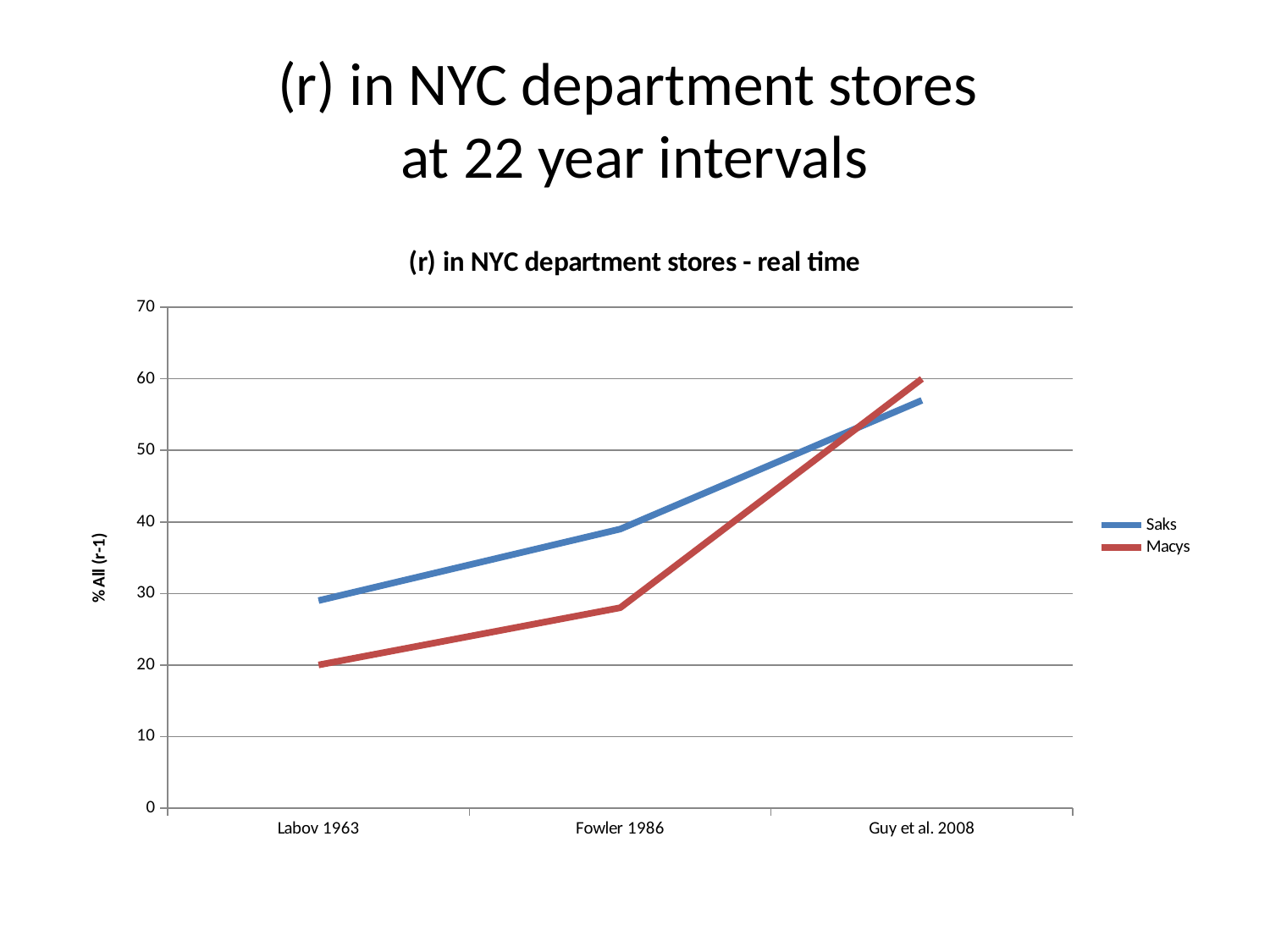
What is the title of the chart? (r) in NYC department stores - real time Is the value for Macys at Guy et al. 2008 greater or less than 50? greater At Fowler 1986, which series has the higher value, Saks or Macys? Saks Does the Saks line rise or fall from Labov 1963 to Guy et al. 2008? rise How many series does the legend list? 2 Is the value for Saks at Labov 1963 greater or less than 20? greater At Labov 1963, which series has the higher value, Saks or Macys? Saks What kind of chart is shown on the slide? line chart How many points along the x axis does each line have? 3 Is the value for Macys at Fowler 1986 greater or less than 30? less Does the Macys line rise or fall from Labov 1963 to Guy et al. 2008? rise What is the label on the y axis? % All (r-1)